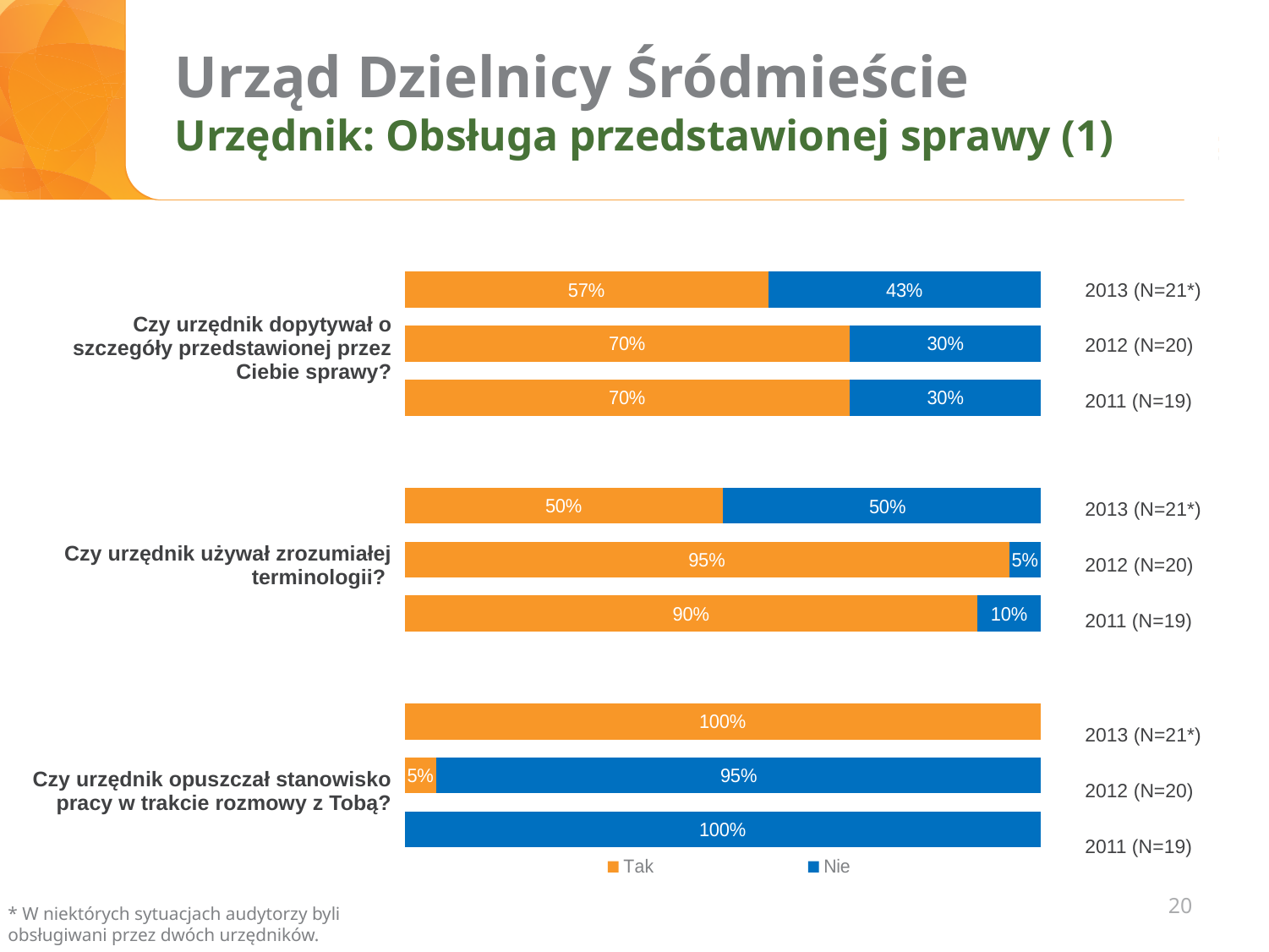
What is the 'Nie' value for 'Czy urzędnik opuszczał stanowisko pracy w trakcie rozmowy z Tobą?' in 2012 (N=20)? 95% What is the 'Tak' value for 'Czy urzędnik dopytywał o szczegóły przedstawionej przez Ciebie sprawy?' in 2013 (N=21*)? 57% For 'Czy urzędnik używał zrozumiałej terminologii?', is the 'Tak' value larger in 2011 (N=19) or in 2012 (N=20)? 2012 (N=20) What is the 'Nie' value for 'Czy urzędnik używał zrozumiałej terminologii?' in 2011 (N=19)? 10% What is the 'Tak' value for 'Czy urzędnik używał zrozumiałej terminologii?' in 2012 (N=20)? 95% For 'Czy urzędnik używał zrozumiałej terminologii?', which year has the lowest 'Tak' value? 2013 (N=21*) How many bars are plotted on the chart in total? 9 How many series does the legend list? 2 What are the two legend entries? Tak and Nie What is the 'Nie' value for 'Czy urzędnik dopytywał o szczegóły przedstawionej przez Ciebie sprawy?' in 2012 (N=20)? 30% For 'Czy urzędnik dopytywał o szczegóły przedstawionej przez Ciebie sprawy?', what is the difference between the 'Tak' values for 2012 (N=20) and 2013 (N=21*)? 13% What kind of chart is shown on the slide? stacked bar chart